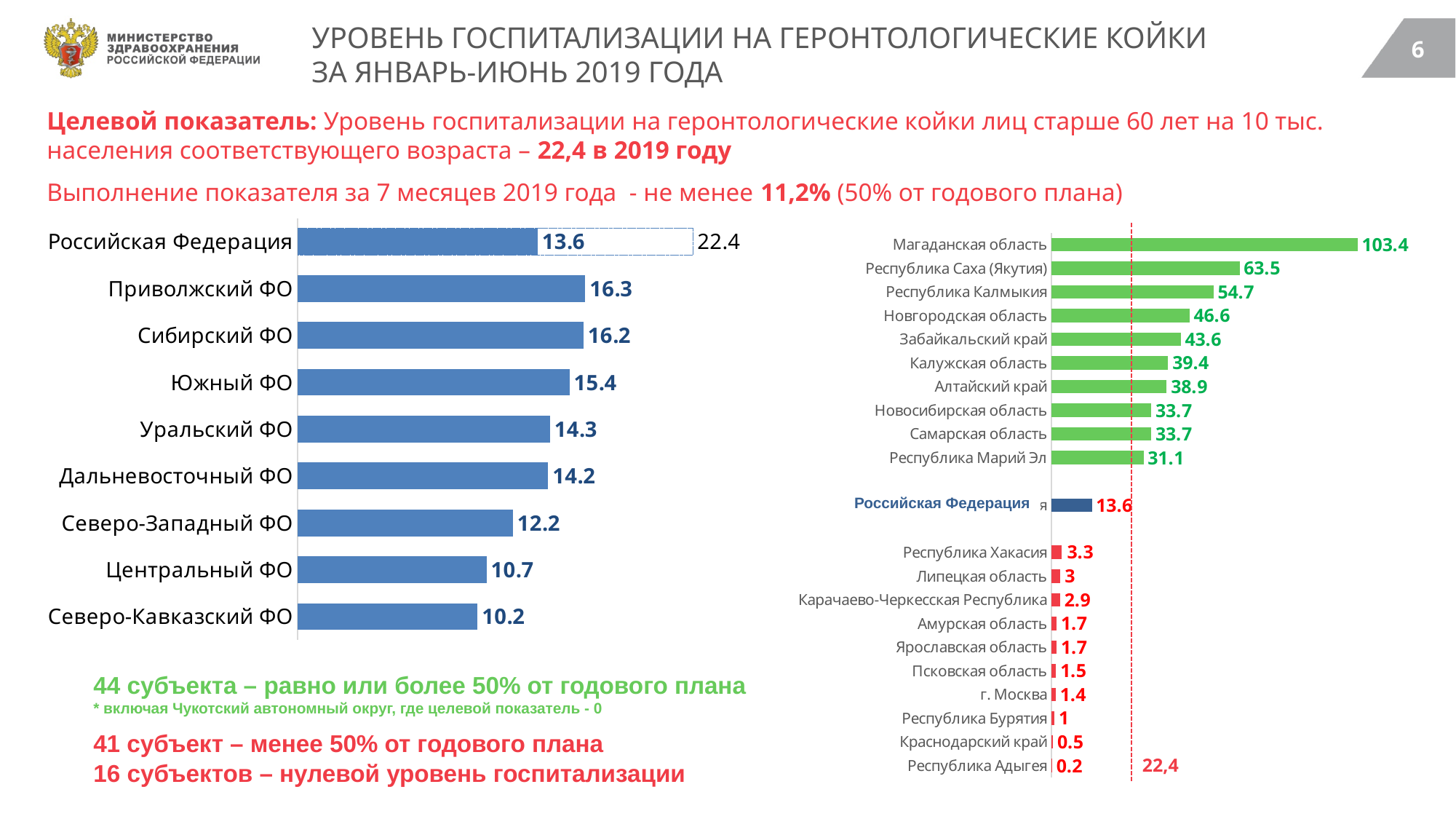
On the left chart, which is larger: Уральский ФО or Северо-Западный ФО? Уральский ФО On the right chart, what is the value for Магаданская область? 103.4 On the right chart, what value does the red dashed vertical line mark? 22,4 On the left chart, what is the value for Приволжский ФО? 16.3 On the right chart, what is the difference between Республика Саха (Якутия) and Республика Калмыкия? 8.8 On the left chart, what is the difference between Приволжский ФО and Центральный ФО? 5.6 What type of chart is shown on the left side of the slide? Bar chart On the right chart, what is the value for Республика Адыгея? 0.2 On the left chart, how many bars are plotted? 9 On the left chart, what is the value for Северо-Кавказский ФО? 10.2 On the left chart, which federal district has the lowest value? Северо-Кавказский ФО On the right chart, which region has the highest value? Магаданская область